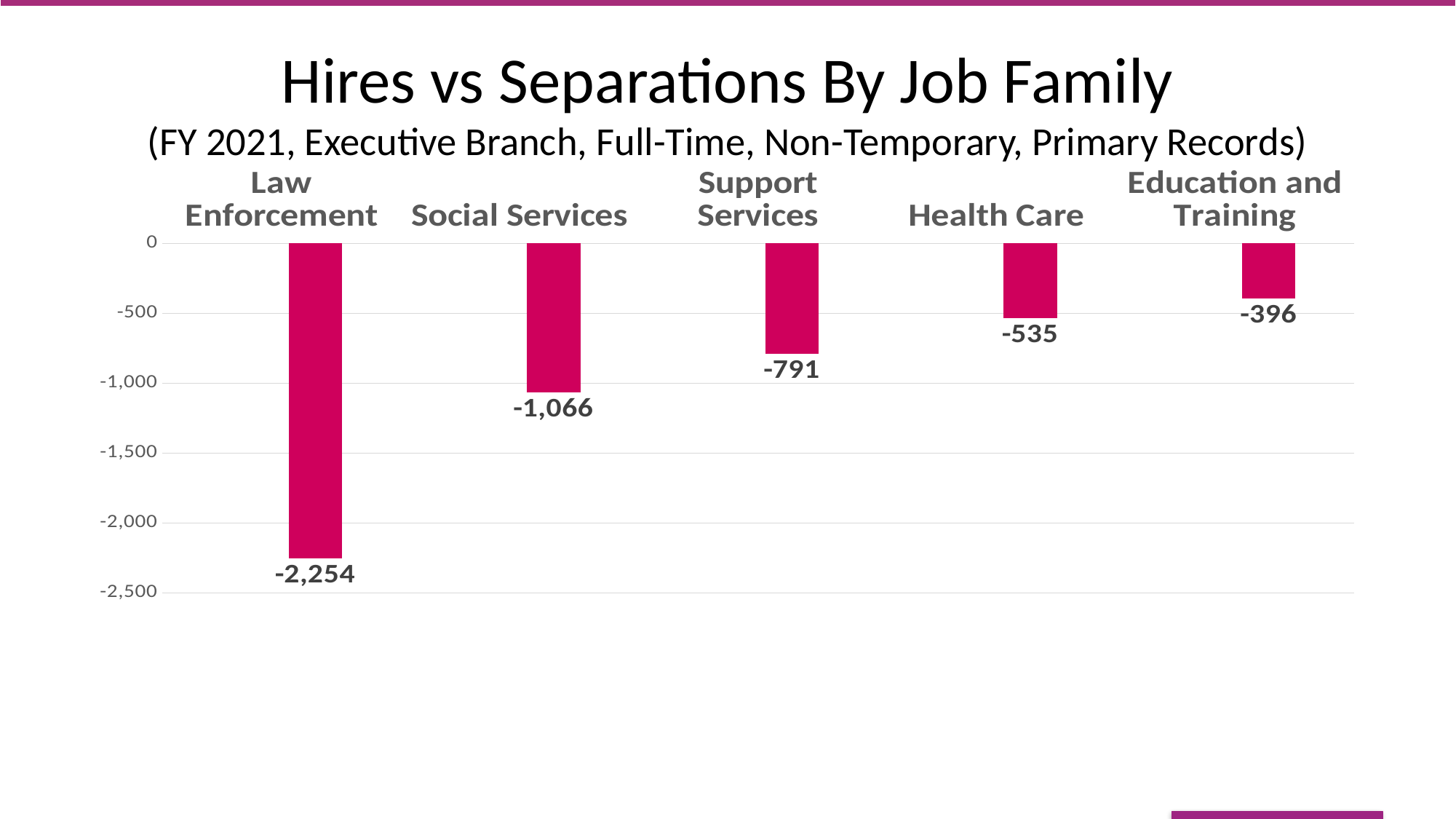
What is the value for Law Enforcement? -2,254 What is the value for Support Services? -791 What kind of chart is shown on the slide? Bar chart Do the values rise or fall moving from left to right across the job families? Rise What is the difference between the values for Law Enforcement and Social Services? 1,188 Which job family has the most negative value (the lowest value)? Law Enforcement What is the value for Education and Training? -396 What is the value for Social Services? -1,066 Which job family has the highest (least negative) value? Education and Training How many job families are shown in the chart? 5 What is the value for Health Care? -535 Which has the larger (less negative) value, Support Services or Health Care? Health Care